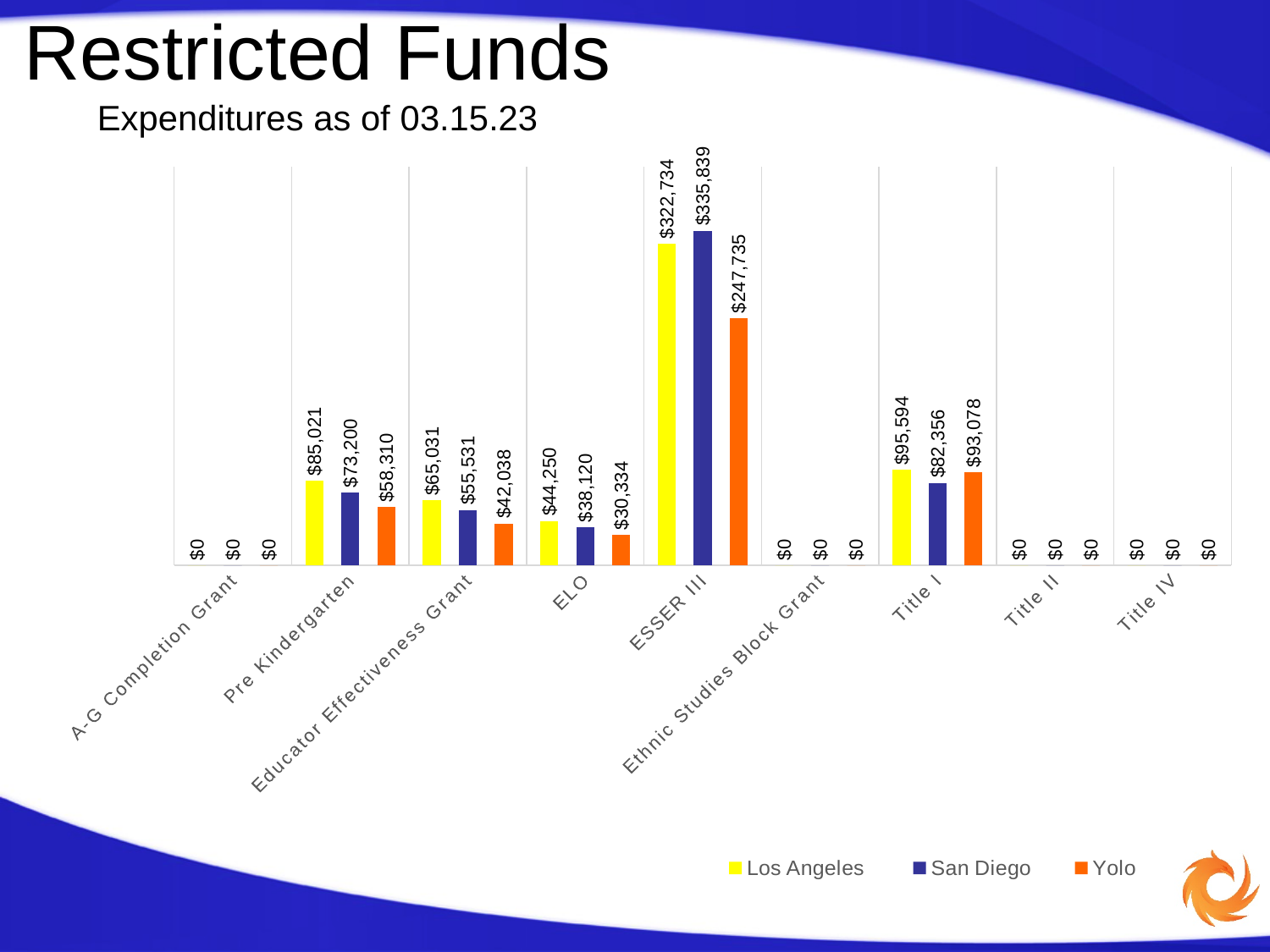
What is the Yolo expenditure for Pre Kindergarten? $58,310 Which is larger for Title I: the Los Angeles expenditure or the Yolo expenditure? Los Angeles Which category has the highest San Diego expenditure? ESSER III What is the Yolo expenditure for ELO? $30,334 How many categories are shown on the x axis? 9 What is the difference between the San Diego and Los Angeles expenditures for ESSER III? $13,105 Among the categories with non-zero values, which has the lowest Yolo expenditure? ELO What kind of chart is shown on the slide? Bar chart What is the total expenditure across all three series for Educator Effectiveness Grant? $162,600 What is the San Diego expenditure for Title I? $82,356 How many series does the legend list? 3 What is the Los Angeles expenditure for ESSER III? $322,734